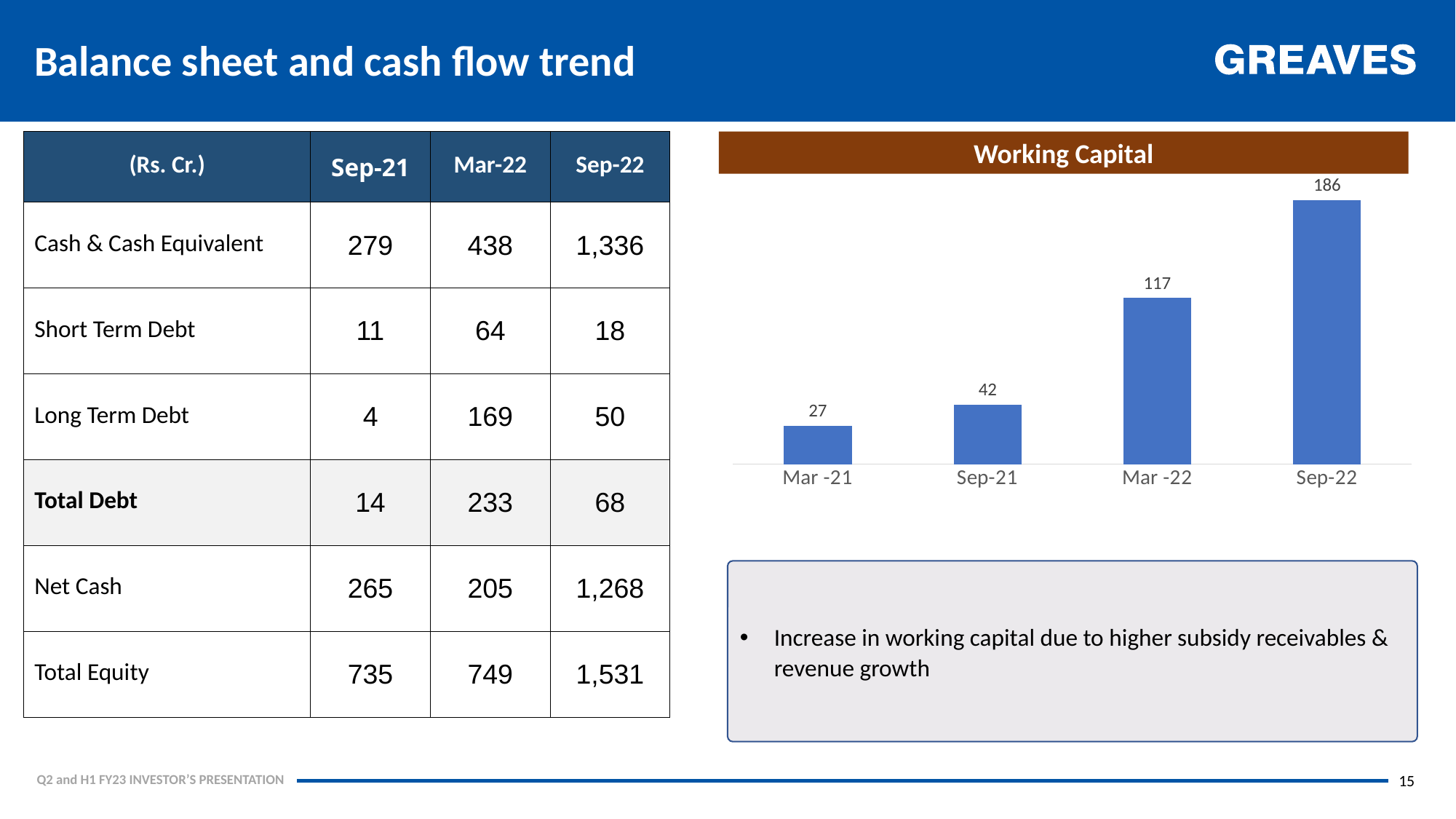
Does working capital rise or fall from Mar -21 to Sep-22? Rise What is the working capital value for Sep-21? 42 Which is larger, the working capital for Mar -22 or for Sep-21? Mar -22 What is the working capital value for Mar -21? 27 What is the difference in working capital between Sep-21 and Mar -21? 15 Which period has the highest working capital? Sep-22 What kind of chart is the Working Capital chart? Bar chart What is the difference in working capital between Sep-22 and Mar -22? 69 What is the working capital value for Sep-22? 186 Which period has the lowest working capital? Mar -21 How many periods are shown in the Working Capital chart? 4 What is the working capital value for Mar -22? 117